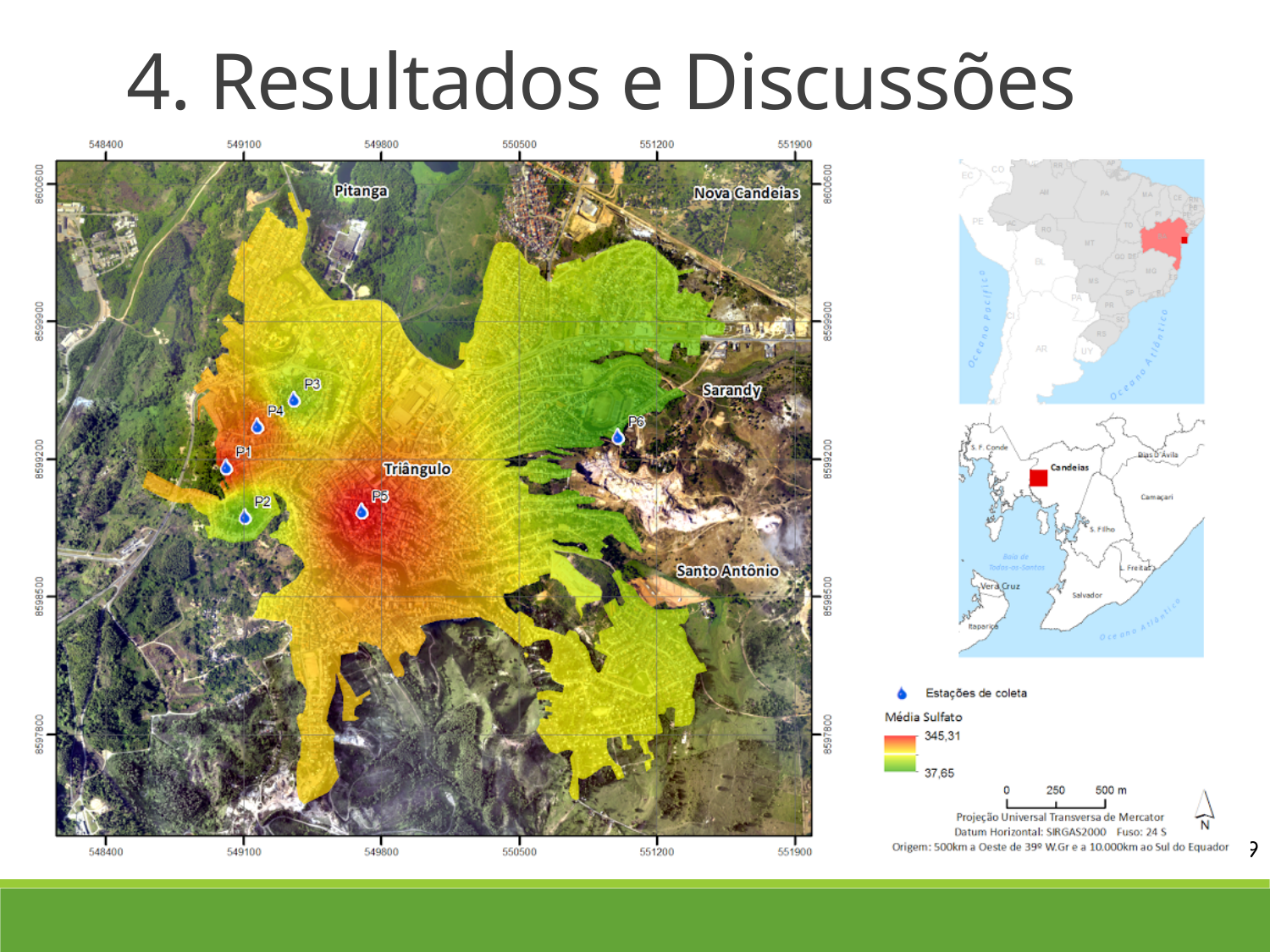
Is station P6 located in a green area or a red area of the map? green What is the largest distance marked on the scale bar? 500 m What is the lowest value shown on the "Média Sulfato" colour legend? 37,65 What is the difference between the highest and lowest values on the "Média Sulfato" legend? 307,66 What label does the legend give to the blue drop symbol? Estações de coleta What is the highest value shown on the "Média Sulfato" colour legend? 345,31 Which collection station is closest to the "Triângulo" label? P5 How many collection stations (Estações de coleta) are marked on the map? 6 Which collection station is located in the darkest red area of the map, indicating the highest sulfate average? P5 What kind of visualization is shown on the slide? map